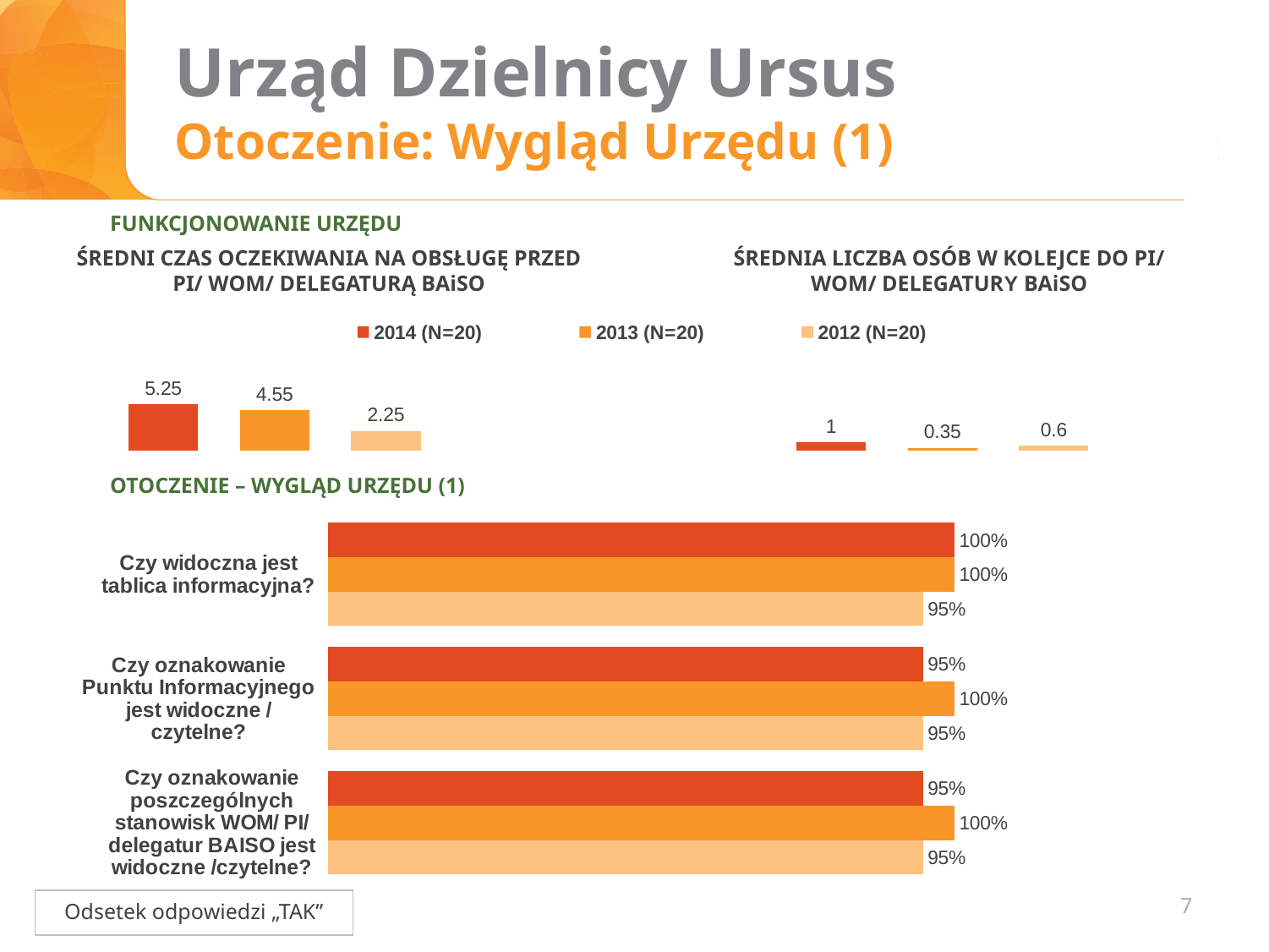
In the chart 'ŚREDNIA LICZBA OSÓB W KOLEJCE DO PI/ WOM/ DELEGATURY BAiSO', which year has the highest value? 2014 (N=20) In the bottom chart 'OTOCZENIE – WYGLĄD URZĘDU (1)', what is the 2012 value for 'Czy widoczna jest tablica informacyjna?'? 95% In the bottom chart 'OTOCZENIE – WYGLĄD URZĘDU (1)', how many question categories are shown? 3 In the chart 'ŚREDNIA LICZBA OSÓB W KOLEJCE DO PI/ WOM/ DELEGATURY BAiSO', what is the value for 2013 (N=20)? 0.35 What type of chart is the bottom chart 'OTOCZENIE – WYGLĄD URZĘDU (1)'? bar chart In the chart 'ŚREDNIA LICZBA OSÓB W KOLEJCE DO PI/ WOM/ DELEGATURY BAiSO', is the value for 2012 larger or smaller than the value for 2013? larger In the bottom chart 'OTOCZENIE – WYGLĄD URZĘDU (1)', what is the 2014 value for 'Czy oznakowanie Punktu Informacyjnego jest widoczne / czytelne?'? 95% In the chart 'ŚREDNI CZAS OCZEKIWANIA NA OBSŁUGĘ PRZED PI/ WOM/ DELEGATURĄ BAiSO', what is the difference between the 2014 and 2013 values? 0.7 In the chart 'ŚREDNI CZAS OCZEKIWANIA NA OBSŁUGĘ PRZED PI/ WOM/ DELEGATURĄ BAiSO', which year has the lowest value? 2012 (N=20) How many series does the legend list for the top charts? 3 In the bottom chart 'OTOCZENIE – WYGLĄD URZĘDU (1)', what is the difference between the 2013 and 2012 values for 'Czy oznakowanie poszczególnych stanowisk WOM/ PI/ delegatur BAISO jest widoczne /czytelne?'? 5% In the chart 'ŚREDNI CZAS OCZEKIWANIA NA OBSŁUGĘ PRZED PI/ WOM/ DELEGATURĄ BAiSO', what is the value for 2014 (N=20)? 5.25